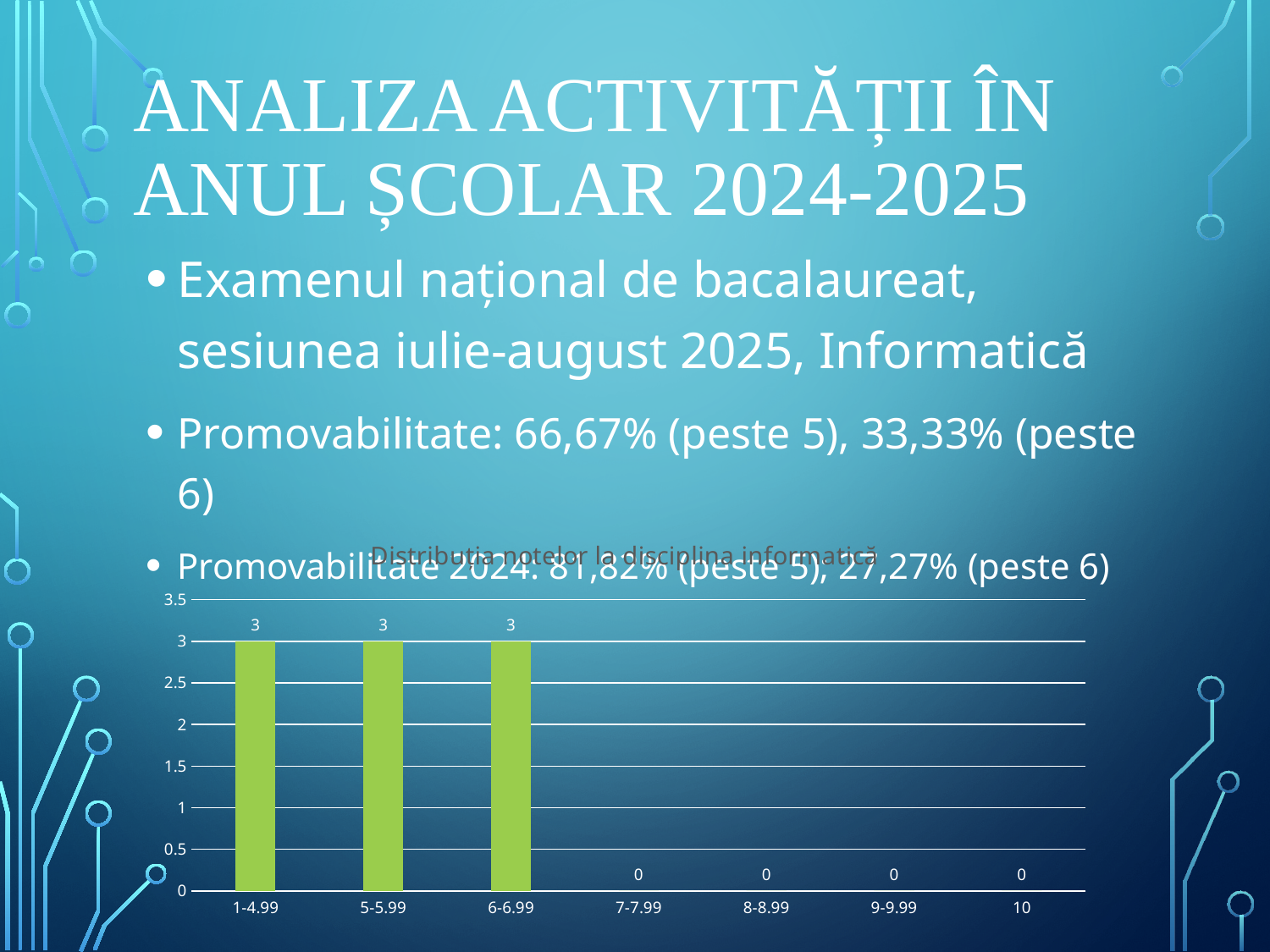
Which is larger, the value for 6-6.99 or the value for 9-9.99? 6-6.99 What is the total of all the values plotted in the chart? 9 How many categories are shown on the x axis of the chart? 7 Is the value for 5-5.99 greater or less than 2.5? greater What is the difference between the value for 1-4.99 and the value for 8-8.99? 3 What is the value for the 5-5.99 category? 3 What is the value for the 10 category? 0 What is the title of the chart? Distribuția notelor la disciplina informatică What kind of chart is shown on the slide? bar chart What is the value for the 1-4.99 category? 3 What is the value for the 7-7.99 category? 0 What is the value for the 6-6.99 category? 3